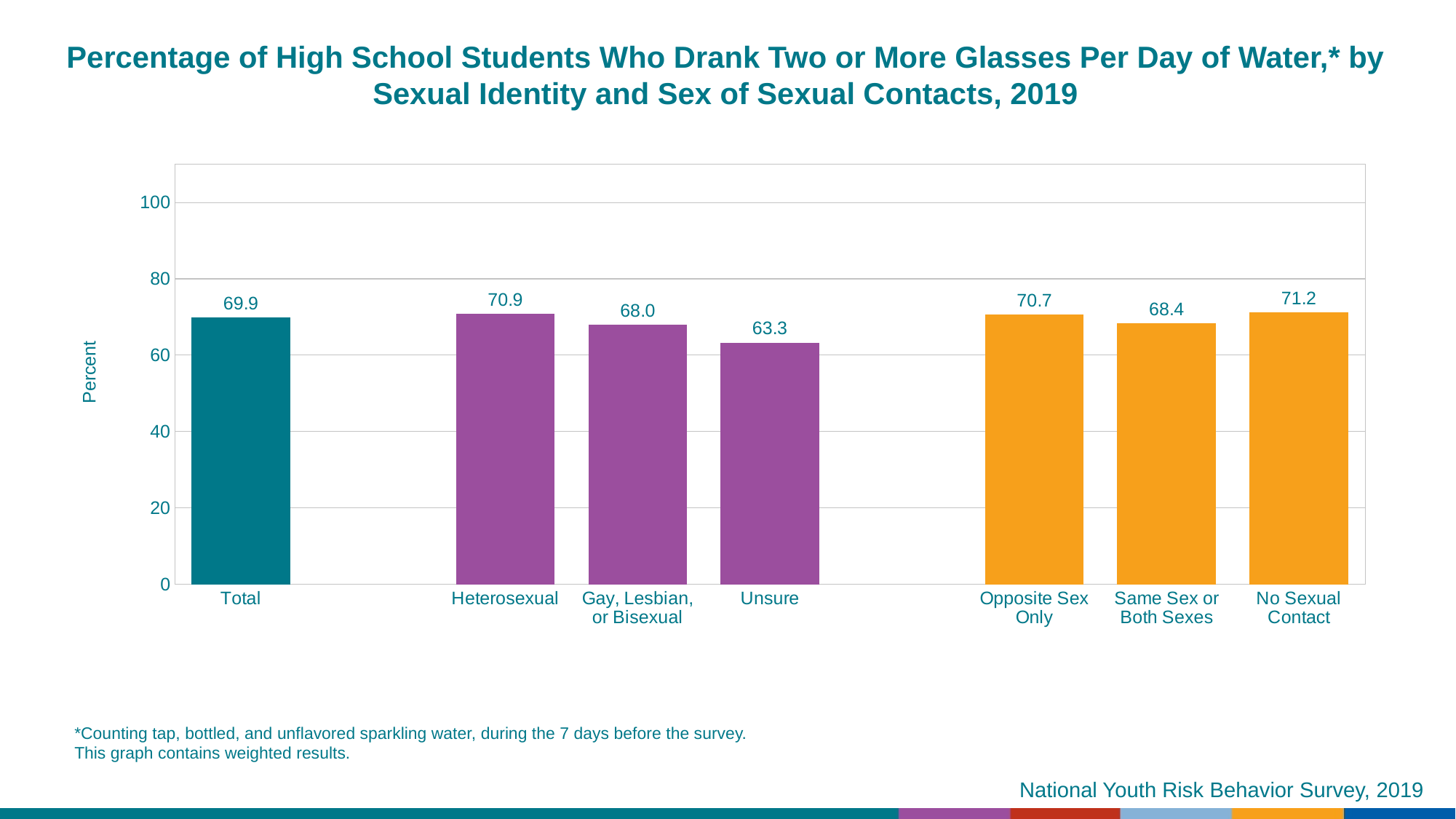
Is the value for Opposite Sex Only greater or less than 60? greater What is the difference between the values for Heterosexual and Unsure? 7.6 What is the value for Total? 69.9 Which is larger, the value for Heterosexual or the value for Gay, Lesbian, or Bisexual? Heterosexual What is the value for Same Sex or Both Sexes? 68.4 Which category has the lowest value? Unsure What is the difference between the values for No Sexual Contact and Same Sex or Both Sexes? 2.8 What is the value for Unsure? 63.3 Which category has the highest value? No Sexual Contact What kind of chart is shown on the slide? bar chart How many categories are shown in the chart? 7 What is the value for Gay, Lesbian, or Bisexual? 68.0